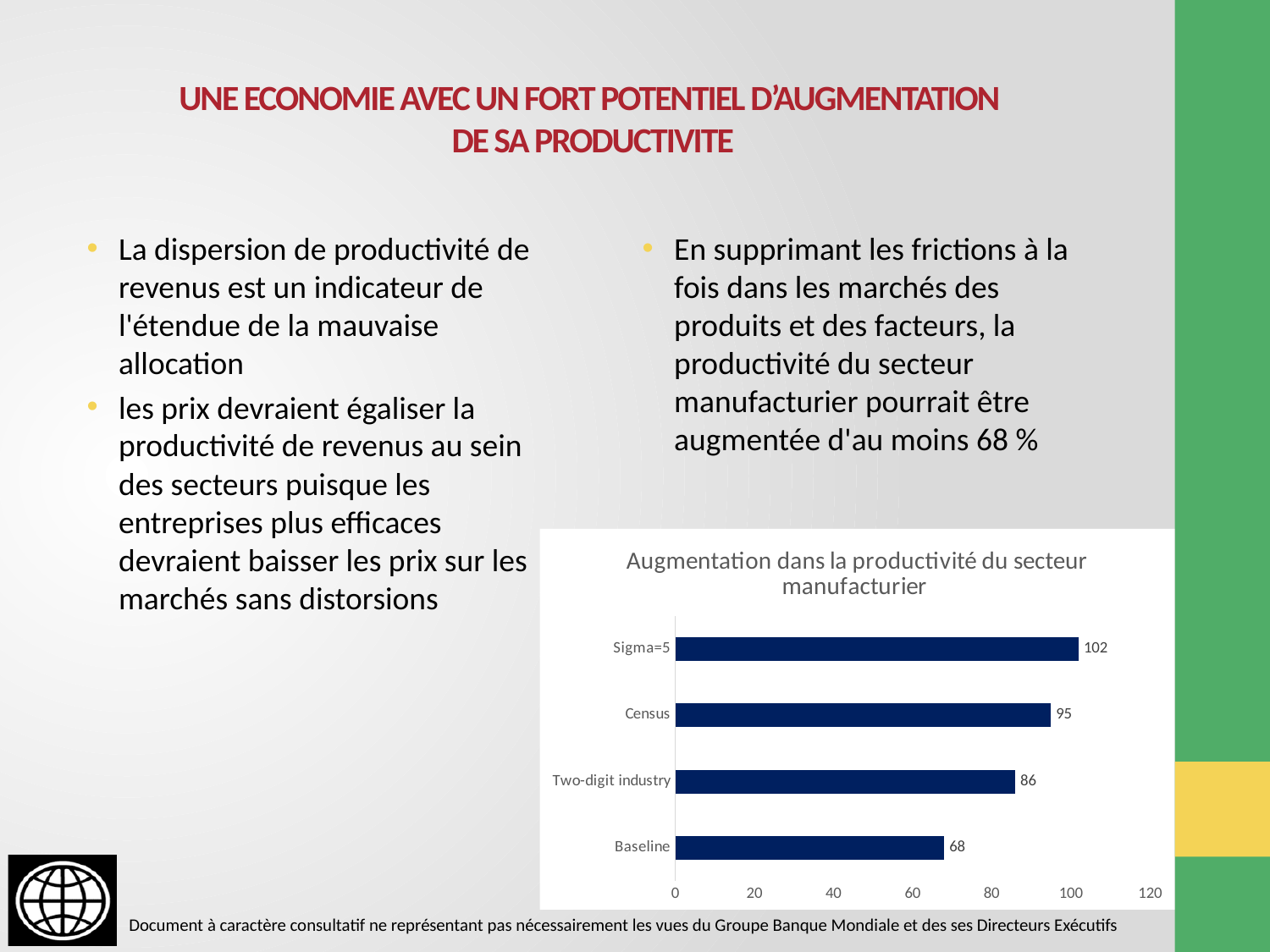
What is the title of the chart? Augmentation dans la productivité du secteur manufacturier What is the value for Sigma=5? 102 Which is larger, the value for Census or the value for Two-digit industry? Census What kind of chart is shown on the slide? bar chart Which category has the highest value? Sigma=5 Is the value for Two-digit industry greater or less than 80? greater What is the value for Census? 95 What is the value for Baseline? 68 Which category has the lowest value? Baseline What is the value for Two-digit industry? 86 How many categories are shown in the chart? 4 What is the difference between the values for Sigma=5 and Baseline? 34